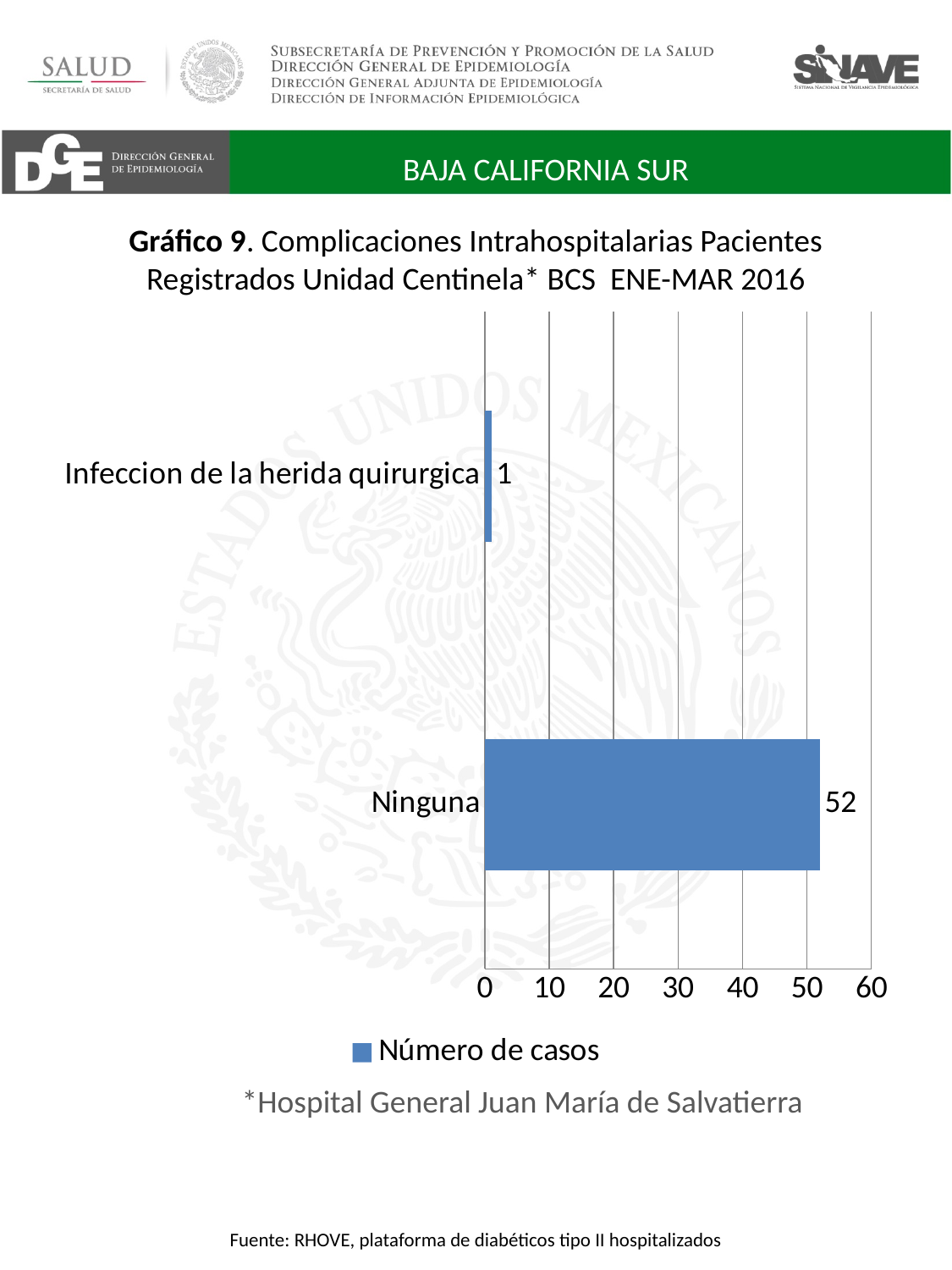
What is the difference between the values for Ninguna and Infeccion de la herida quirurgica? 51 How many categories are shown in the chart? 2 How many series does the legend list? 1 What series name is shown in the legend? Número de casos What is the total of the two values shown in the chart? 53 What kind of chart is shown on the slide? Bar chart Which category has the highest value? Ninguna What is the value for Ninguna? 52 Is the value for Ninguna greater or less than 50? greater Which is larger, the value for Ninguna or the value for Infeccion de la herida quirurgica? Ninguna Which category has the lowest value? Infeccion de la herida quirurgica What is the value for Infeccion de la herida quirurgica? 1